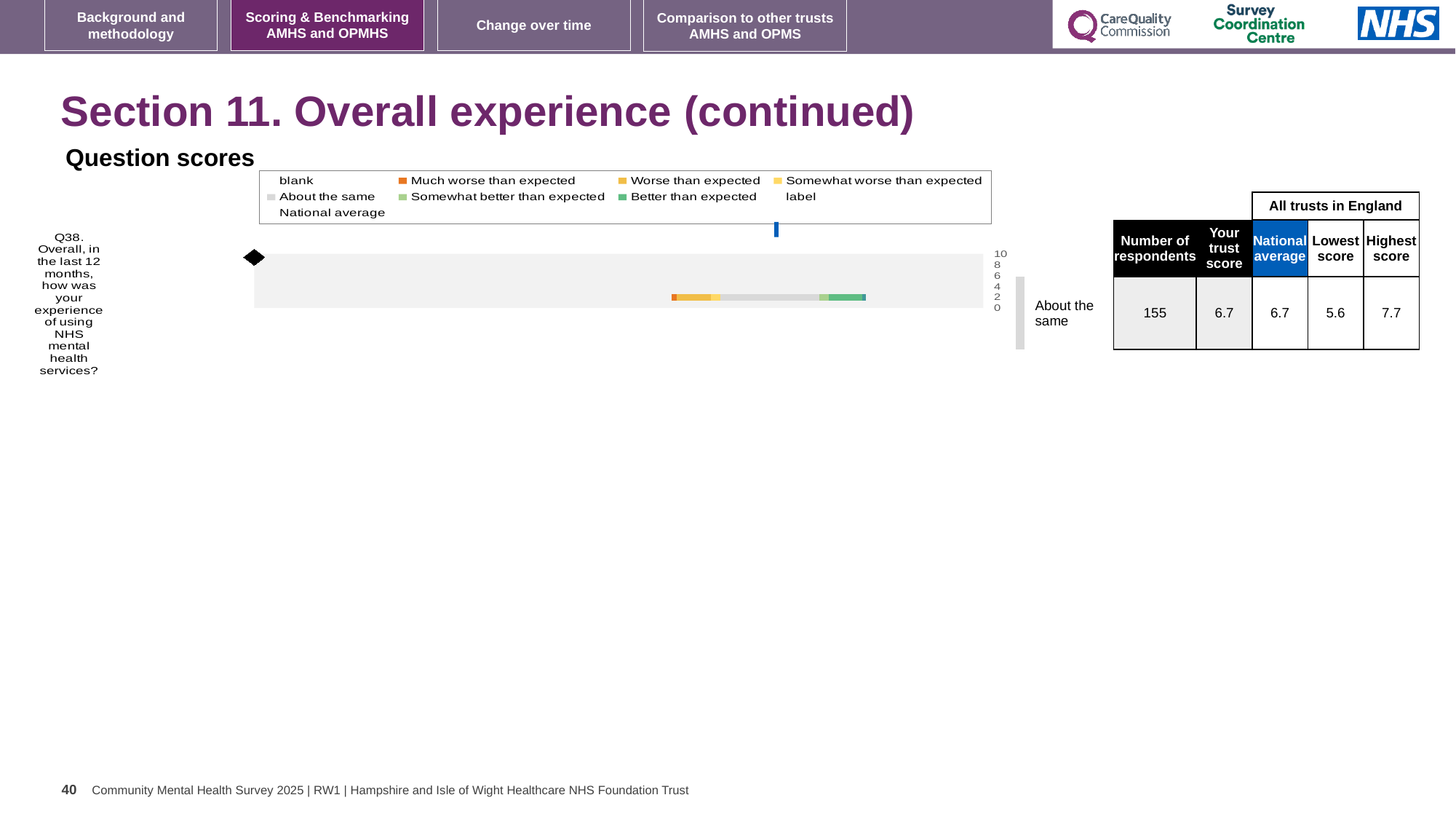
How many entries does the legend of the Question scores chart list? 9 What is the highest tick value shown on the axis of the Question scores chart? 10 What is your trust score for Q38? 6.7 What is the lowest score among all trusts in England for Q38? 5.6 Is your trust score for Q38 higher than, lower than, or the same as the national average? the same What is the national average score for Q38? 6.7 What kind of chart is used to show the Q38 question score? bar chart What is the number of respondents for Q38? 155 How many questions are plotted in the Question scores chart? 1 What is the highest score among all trusts in England for Q38? 7.7 What benchmark category is shown next to the bar for Q38? About the same What is the difference between the highest score and the lowest score for Q38? 2.1